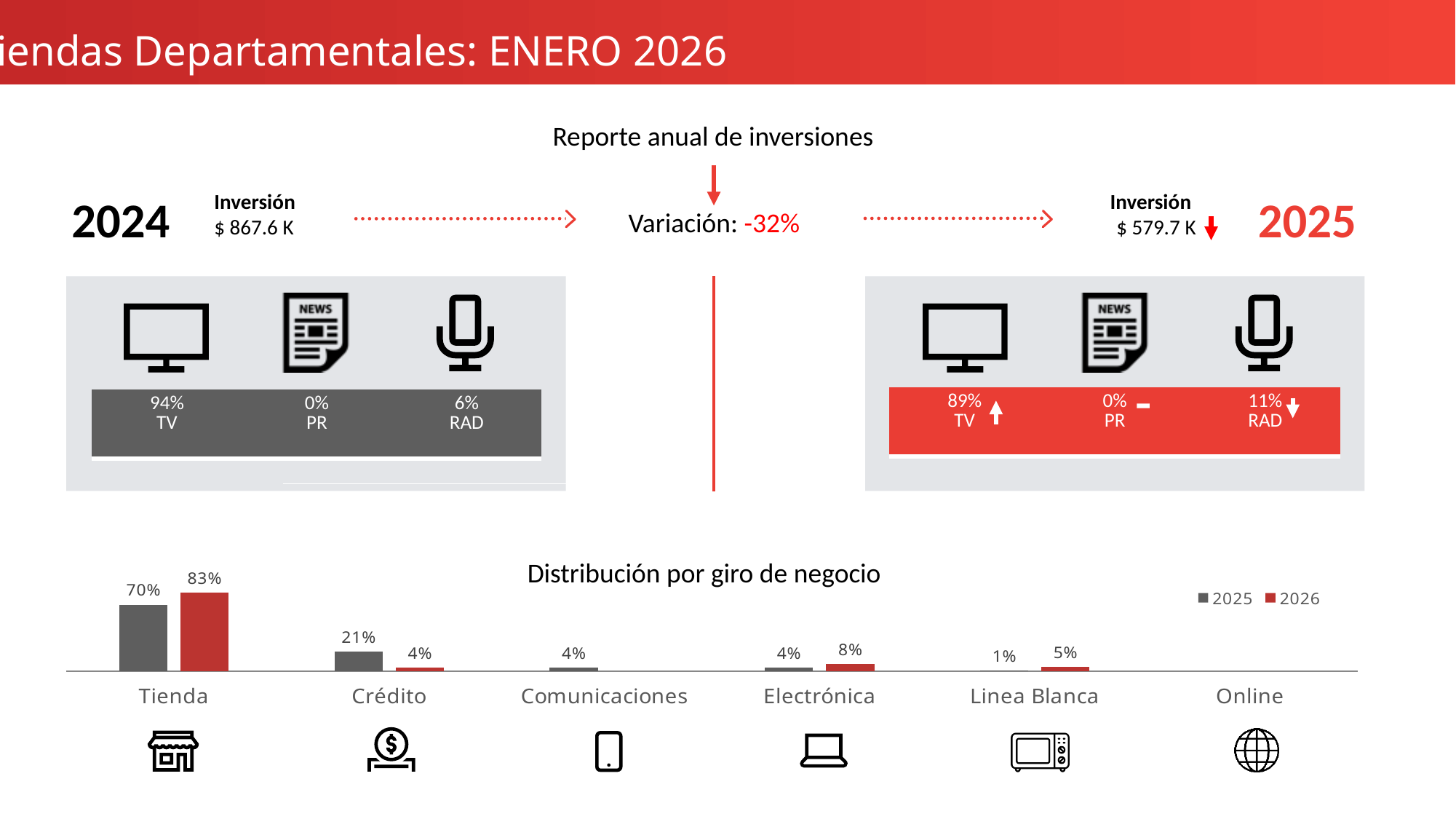
How many categories are shown on the x axis of the 'Distribución por giro de negocio' chart? 6 In the 'Distribución por giro de negocio' chart, which category has the lowest labelled 2025 value? Linea Blanca In the 'Distribución por giro de negocio' chart, what is the 2026 value for Tienda? 83% What type of chart is 'Distribución por giro de negocio'? Bar chart In the 'Distribución por giro de negocio' chart, what is the difference between the 2026 and 2025 values for Tienda? 13% In the 'Distribución por giro de negocio' chart, what is the 2026 value for Electrónica? 8% In the 'Distribución por giro de negocio' chart, which is larger for Electrónica: the 2025 value or the 2026 value? 2026 How many series does the legend of the 'Distribución por giro de negocio' chart list? 2 In the 'Distribución por giro de negocio' chart, what is the 2025 value for Linea Blanca? 1% In the 'Distribución por giro de negocio' chart, what is the 2025 value for Crédito? 21% In the 'Distribución por giro de negocio' chart, what is the difference between the 2025 and 2026 values for Crédito? 17% In the 'Distribución por giro de negocio' chart, which category has the highest 2025 value? Tienda